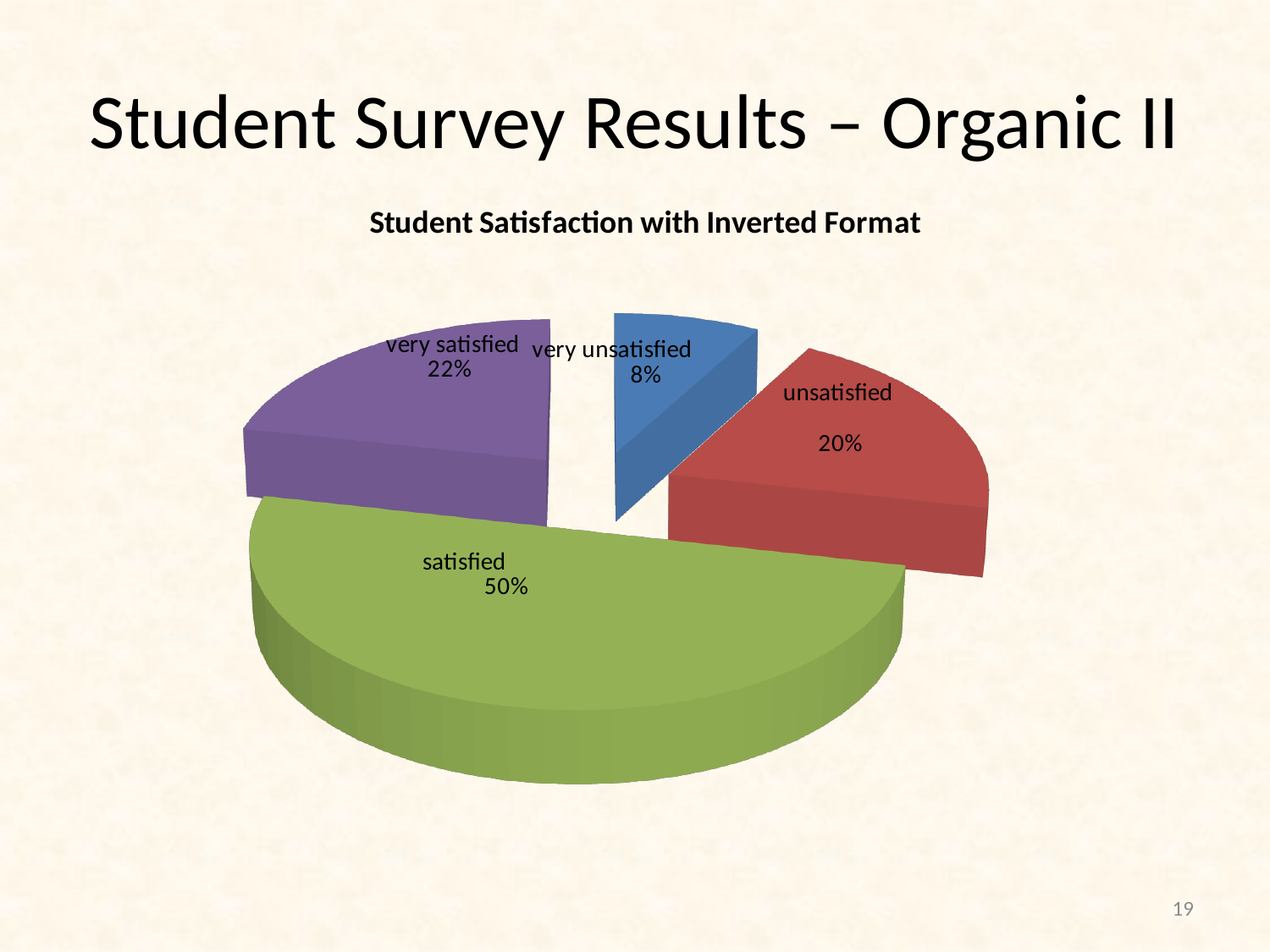
Which slice is larger, "very satisfied" or "unsatisfied"? very satisfied What kind of chart is shown on the slide? pie chart What share of the pie is labelled "satisfied"? 50% What share of the pie is labelled "unsatisfied"? 20% Which category has the smallest slice of the pie? very unsatisfied How many slices does the pie chart have? 4 What is the title of the chart? Student Satisfaction with Inverted Format What share of the pie is labelled "very satisfied"? 22% Which category has the largest slice of the pie? satisfied What is the difference in percentage points between the "satisfied" and "very satisfied" slices? 28 What is the difference in percentage points between the "unsatisfied" and "very unsatisfied" slices? 12